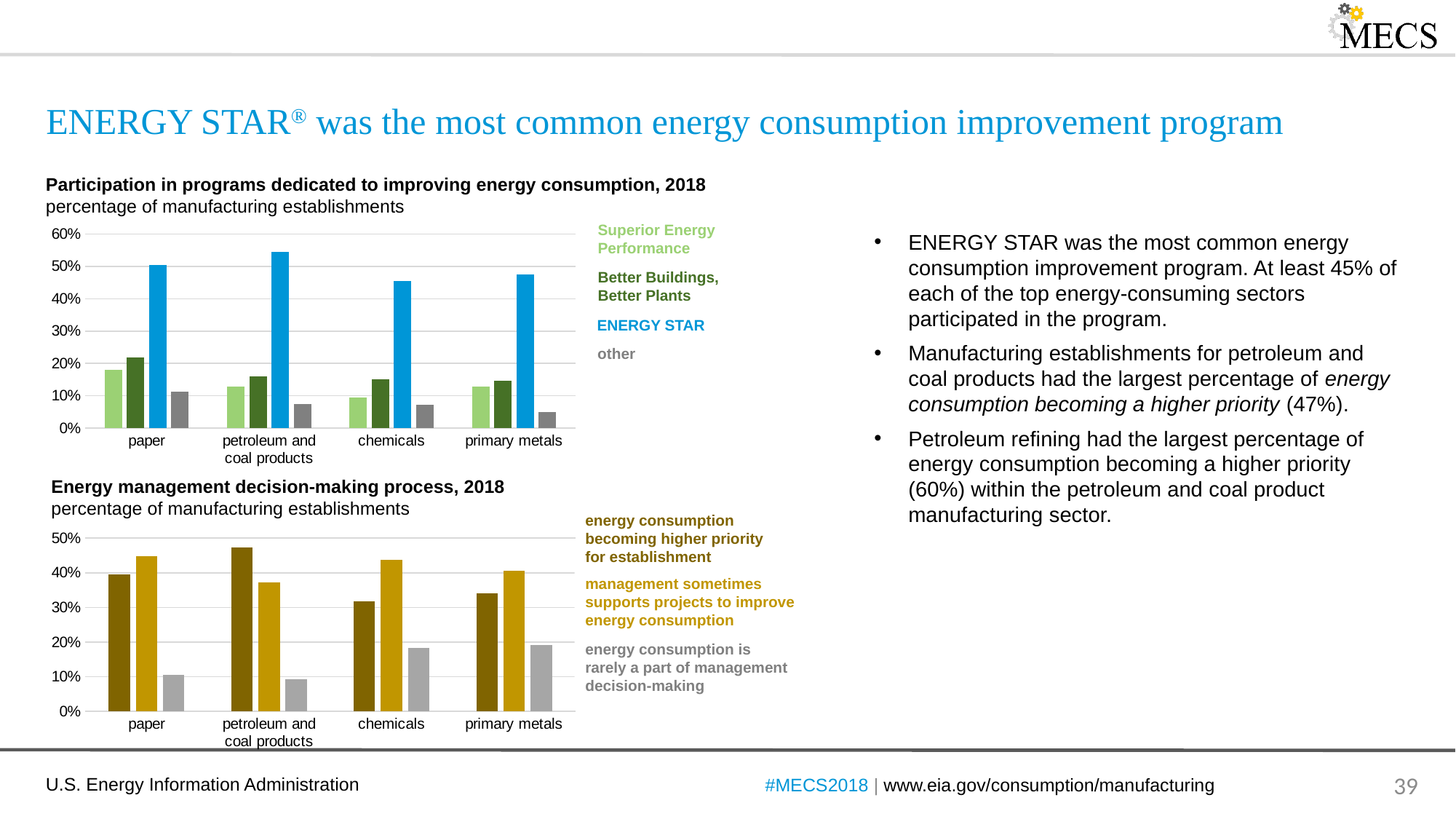
How many series does the legend of the 'Participation in programs dedicated to improving energy consumption, 2018' chart list? 4 What kind of chart is the 'Participation in programs dedicated to improving energy consumption, 2018' chart? bar chart In the 'Participation in programs dedicated to improving energy consumption, 2018' chart, which sector has the highest ENERGY STAR participation? petroleum and coal products How many sector categories are shown on the x axis of the 'Energy management decision-making process, 2018' chart? 4 In the 'Participation in programs dedicated to improving energy consumption, 2018' chart, which colour represents ENERGY STAR? blue In the 'Energy management decision-making process, 2018' chart, which sector has the highest share for 'energy consumption becoming higher priority for establishment'? petroleum and coal products In the 'Energy management decision-making process, 2018' chart, for paper, which is larger: 'energy consumption becoming higher priority for establishment' or 'management sometimes supports projects to improve energy consumption'? management sometimes supports projects to improve energy consumption In the 'Energy management decision-making process, 2018' chart, is the 'energy consumption is rarely a part of management decision-making' value for chemicals greater or less than 10%? greater In the 'Participation in programs dedicated to improving energy consumption, 2018' chart, is the ENERGY STAR value for petroleum and coal products greater or less than 50%? greater In the 'Participation in programs dedicated to improving energy consumption, 2018' chart, is the 'other' value for primary metals greater or less than 10%? less In the 'Participation in programs dedicated to improving energy consumption, 2018' chart, for paper, which is larger: Superior Energy Performance or Better Buildings, Better Plants? Better Buildings, Better Plants